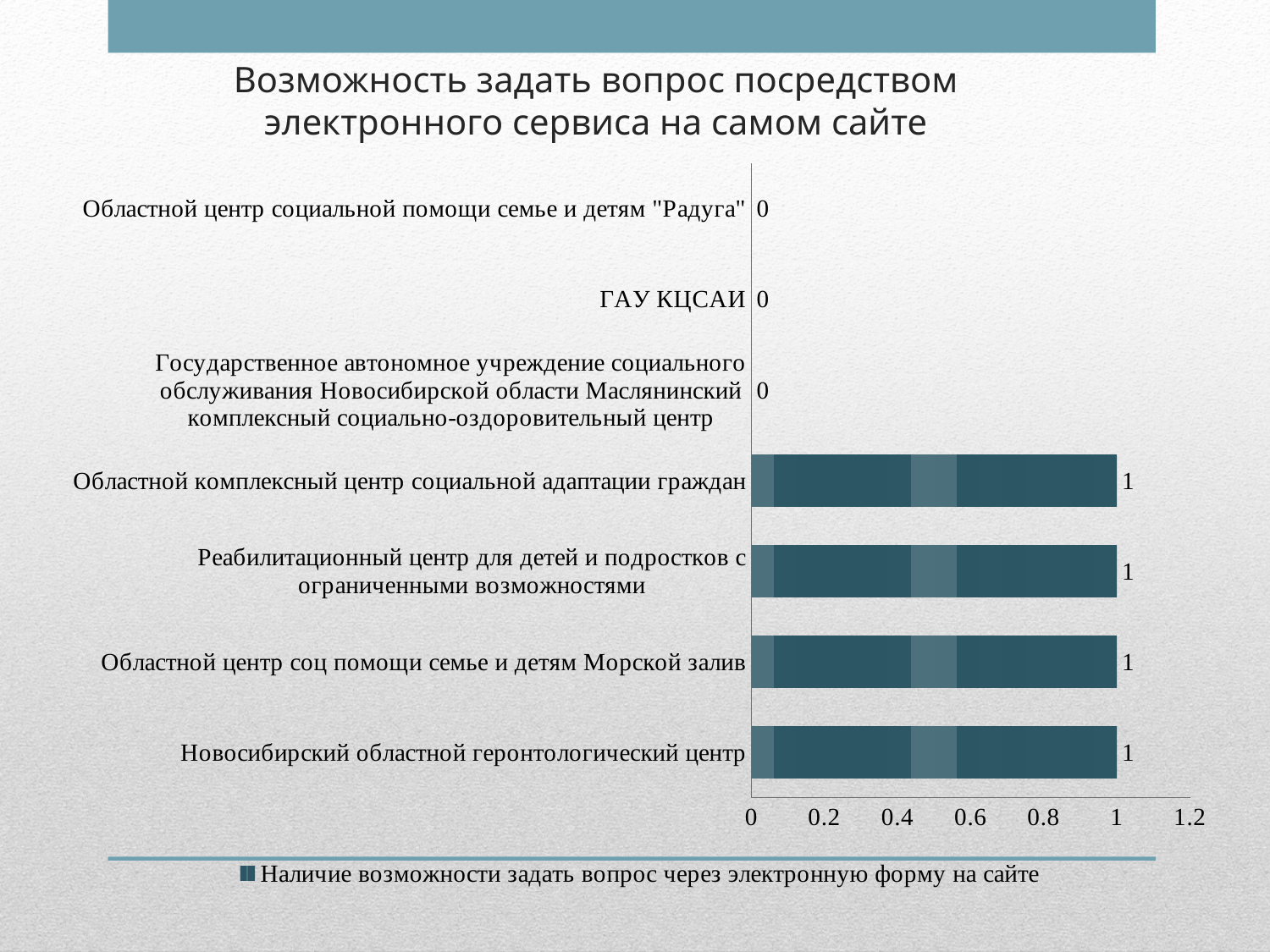
What is the series name shown in the legend? Наличие возможности задать вопрос через электронную форму на сайте What is the value for Областной центр соц помощи семье и детям Морской залив? 1 What is the value for ГАУ КЦСАИ? 0 Which is larger, the value for Областной комплексный центр социальной адаптации граждан or the value for ГАУ КЦСАИ? Областной комплексный центр социальной адаптации граждан What is the value for Областной центр социальной помощи семье и детям "Радуга"? 0 What kind of chart is shown on the slide? bar chart How many categories have a value of 1? 4 How many categories are shown on the chart? 7 How many series does the legend list? 1 What is the title of the chart? Возможность задать вопрос посредством электронного сервиса на самом сайте What is the value for Новосибирский областной геронтологический центр? 1 What is the difference between the value for Реабилитационный центр для детей и подростков с ограниченными возможностями and the value for ГАУ КЦСАИ? 1